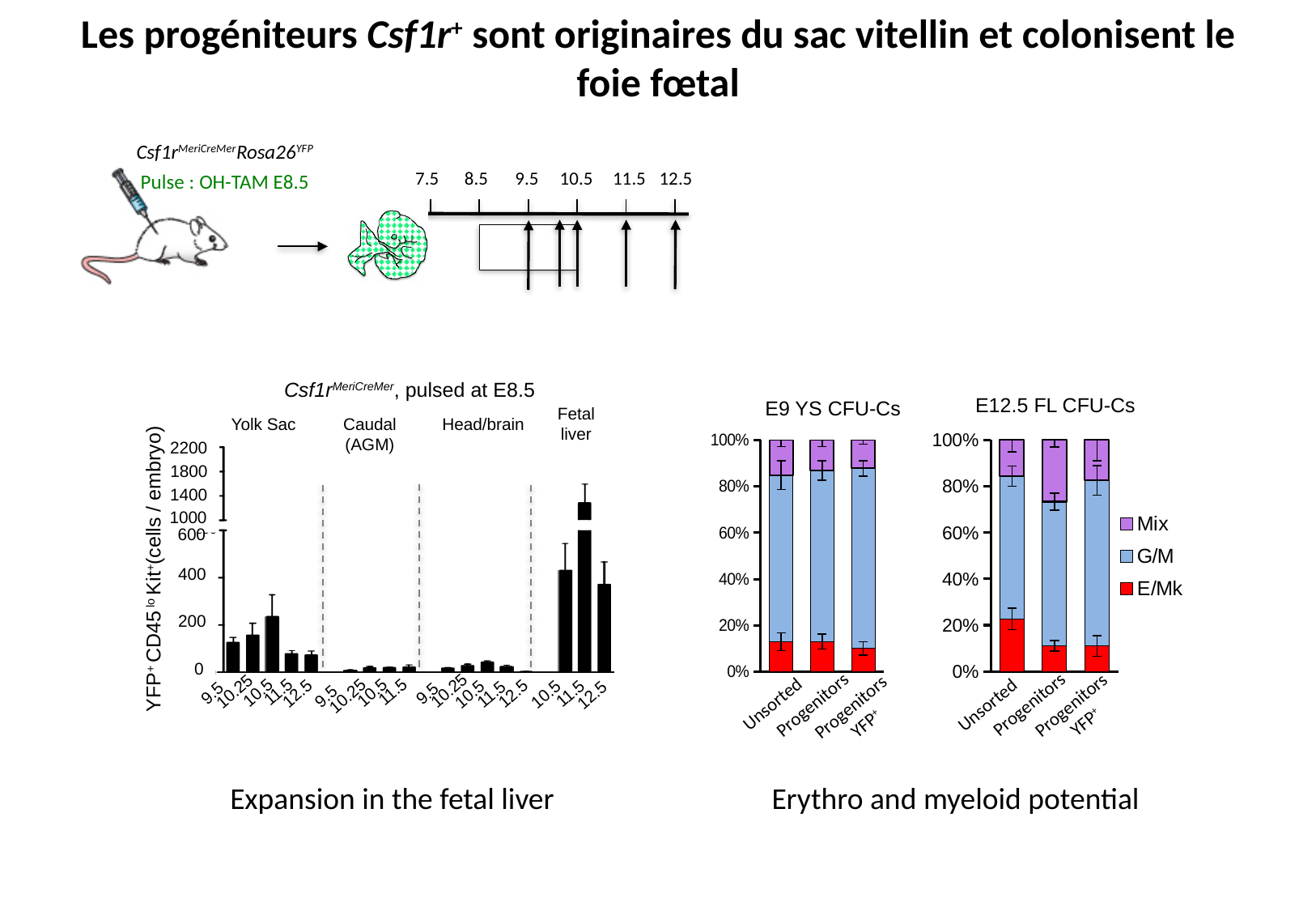
What kind of chart is the 'Csf1r MeriCreMer, pulsed at E8.5' chart on the left? bar chart In the 'Csf1r MeriCreMer, pulsed at E8.5' chart, does the Fetal liver value rise or fall from 11.5 to 12.5? fall In the 'Csf1r MeriCreMer, pulsed at E8.5' chart, which is larger: the Yolk Sac value at 10.5 or at 11.5? 10.5 How many series does the legend of the CFU-Cs charts on the right list? 3 How many categories are shown on the x axis of the 'E9 YS CFU-Cs' chart? 3 How many tissue groups are shown in the 'Csf1r MeriCreMer, pulsed at E8.5' chart? 4 In the 'Csf1r MeriCreMer, pulsed at E8.5' chart, is the value for Yolk Sac at 10.5 greater or less than 400? less In the 'E12.5 FL CFU-Cs' chart, which category has the largest Mix share? Progenitors In the 'Csf1r MeriCreMer, pulsed at E8.5' chart, is the value for Fetal liver at 10.5 greater or less than 200? greater In the 'Csf1r MeriCreMer, pulsed at E8.5' chart, which tissue and stage has the highest bar? Fetal liver 11.5 In the 'E12.5 FL CFU-Cs' chart, is the E/Mk share for Progenitors greater or less than 20%? less